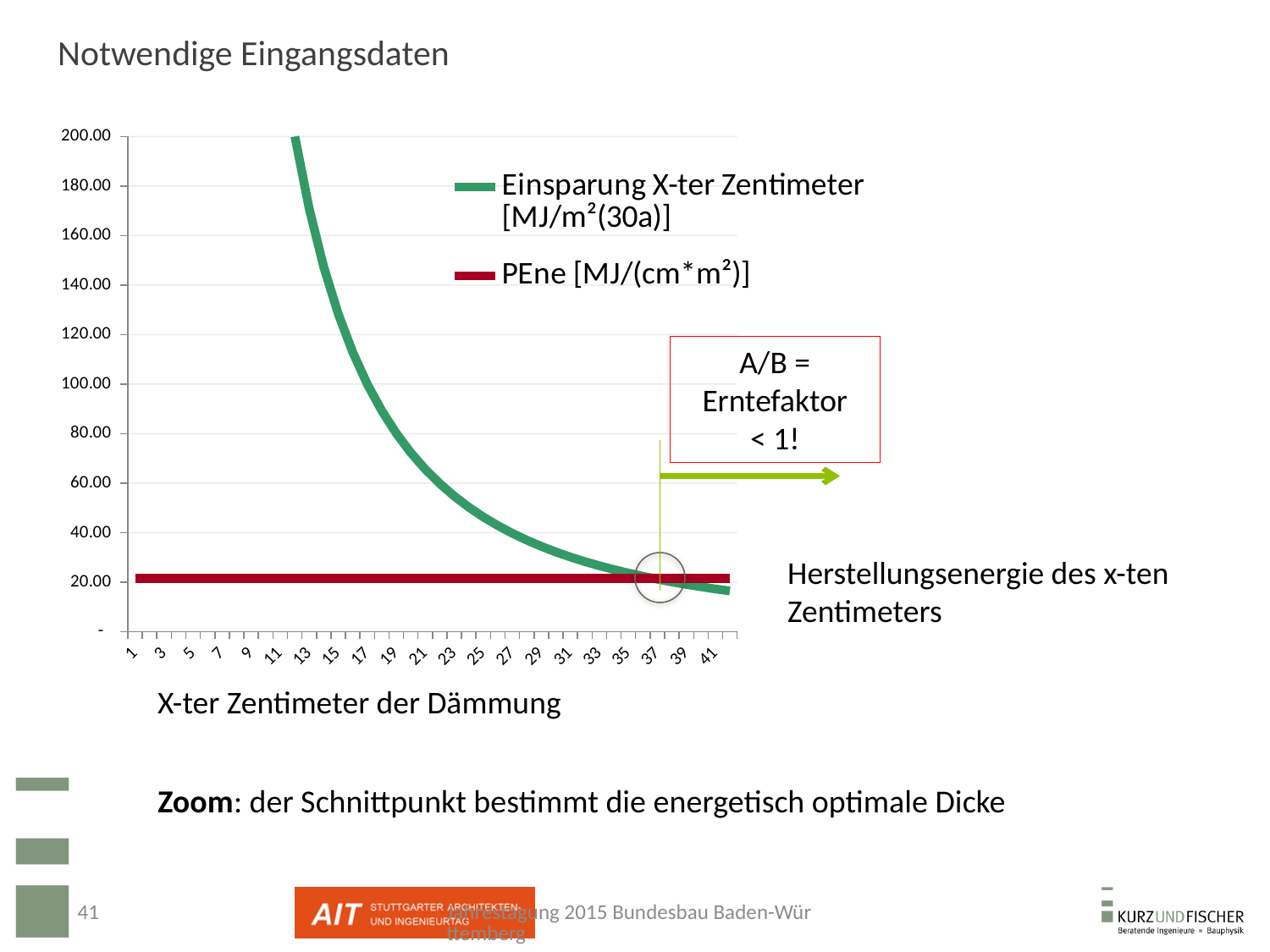
At x = 41, which series has the larger value: 'Einsparung X-ter Zentimeter' or 'PEne'? PEne Is the value of the red 'PEne [MJ/(cm*m²)]' series greater or less than 40? less Is the value of the green 'Einsparung X-ter Zentimeter' series at x = 31 greater or less than 60? less What is the label of the x-axis of the chart? X-ter Zentimeter der Dämmung Does the green series 'Einsparung X-ter Zentimeter [MJ/m²(30a)]' rise or fall as the x-axis value increases? fall Which colour is used for the 'PEne [MJ/(cm*m²)]' series? red What kind of chart is shown on the slide? line chart Is the value of the green 'Einsparung X-ter Zentimeter' series at x = 21 greater or less than 100? less At x = 21, which series has the larger value: 'Einsparung X-ter Zentimeter' or 'PEne'? Einsparung X-ter Zentimeter How many series does the chart legend list? 2